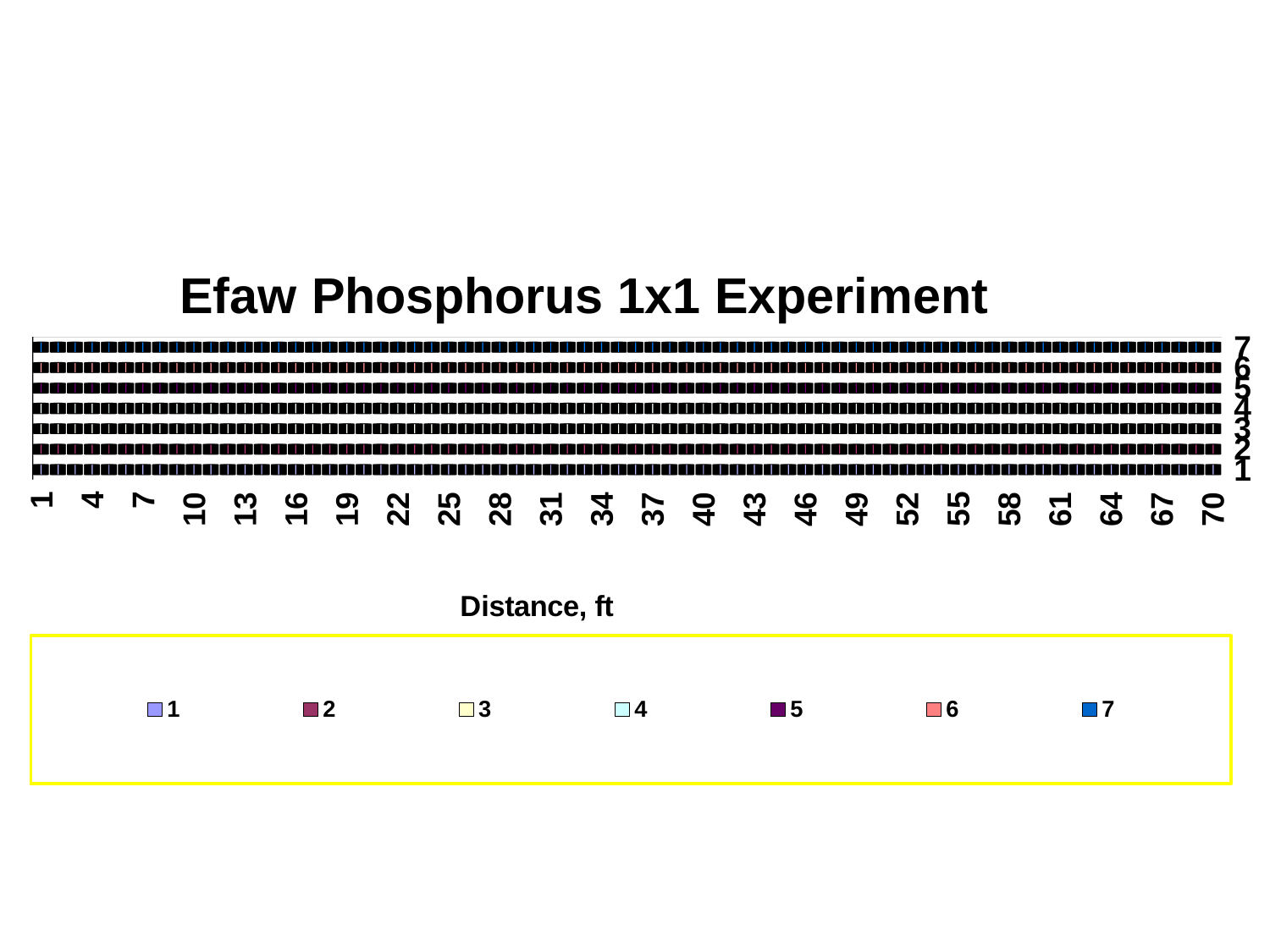
How many rows are labeled on the right-hand axis of the chart? 7 What is the first tick label shown on the chart's x axis? 1 How many series does the chart's legend list? 7 What is the last tick label shown on the chart's x axis? 70 What is the title of the chart? Efaw Phosphorus 1x1 Experiment What is the label of the chart's x axis? Distance, ft What is the highest row number labeled on the right-hand axis of the chart? 7 What is the lowest row number labeled on the right-hand axis of the chart? 1